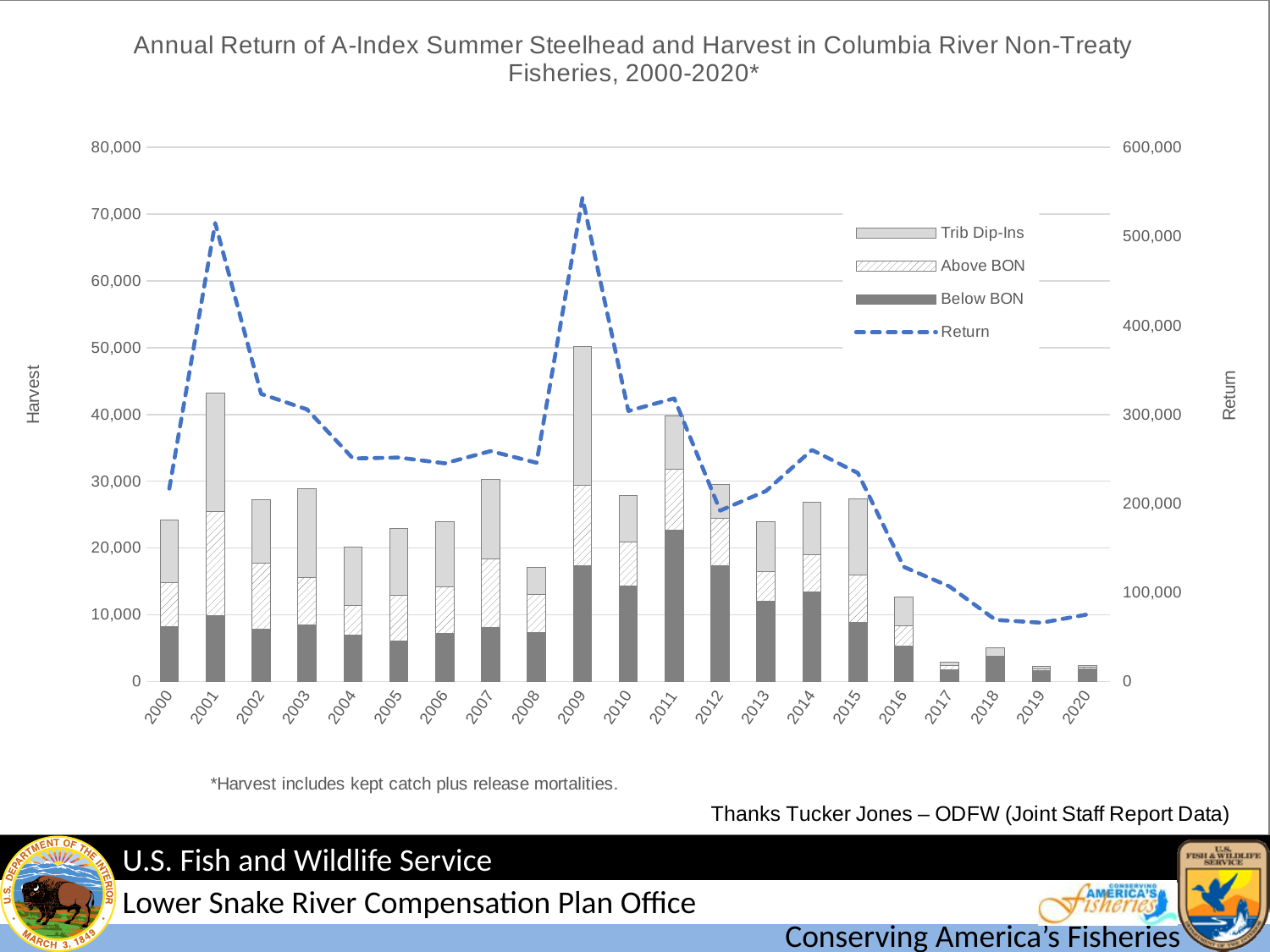
In which year does the Return line reach its highest point? 2009 Is the total harvest for 2016 greater or less than 20,000? less What kind of chart is shown on the slide? A stacked bar chart with a line Is the total harvest for 2009 greater or less than 40,000? greater Which series is drawn as a dashed line? Return Is the Return value for 2009 greater or less than 500,000? greater Which year has the highest total harvest bar? 2009 Which year has the larger total harvest, 2001 or 2002? 2001 Does the total harvest rise or fall from 2015 to 2020? fall How many series does the legend list? 4 How many years are shown along the x axis? 21